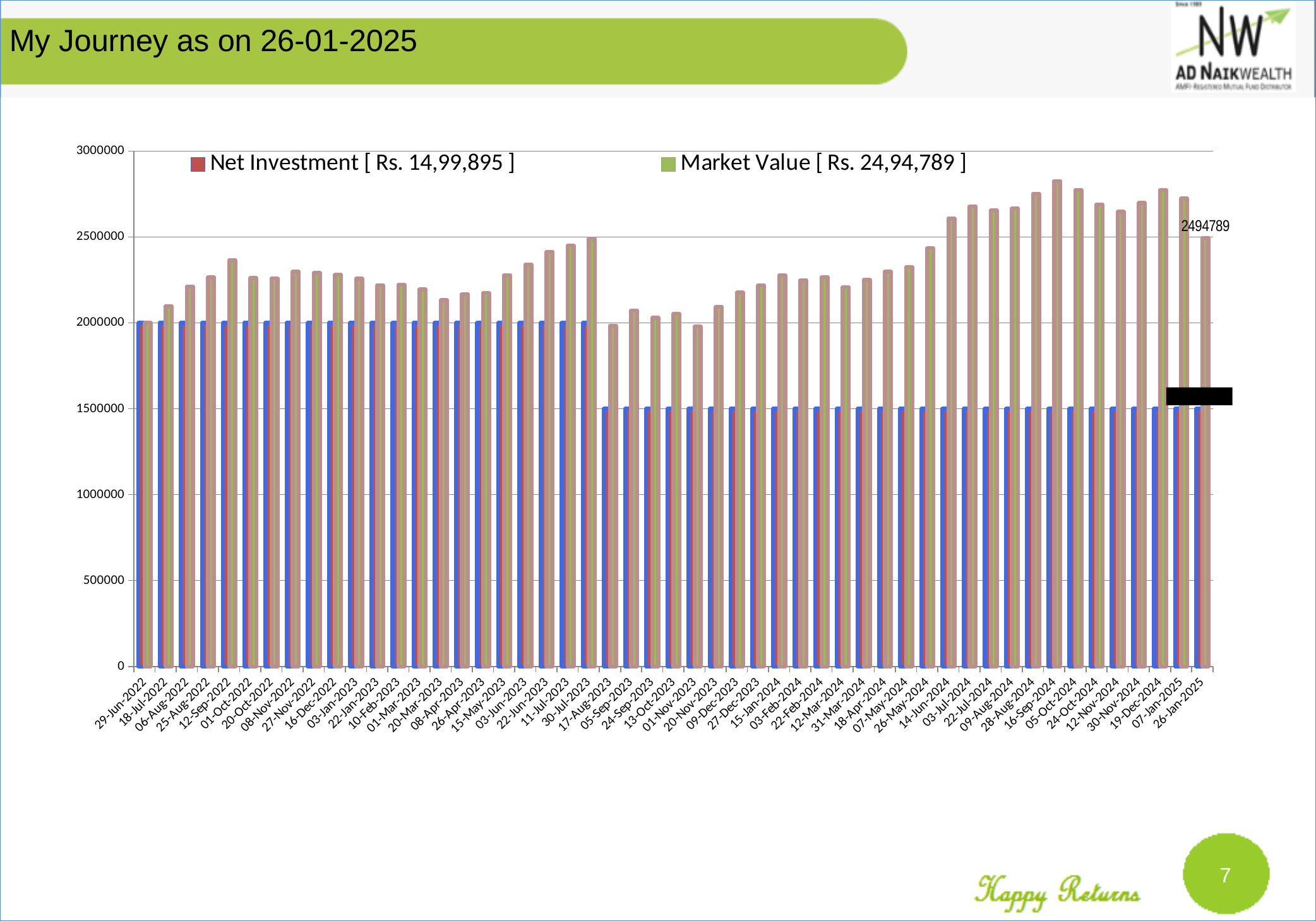
What type of chart is shown on the slide? bar chart Is the Net Investment for 26-Jan-2025 greater or less than 2000000? less How many series does the chart legend list? 2 What is the Market Value data label shown for 26-Jan-2025? 2494789 On which date is the Market Value bar highest? 16-Sep-2024 Which is larger, the Market Value on 16-Sep-2024 or on 26-Jan-2025? 16-Sep-2024 Is the Market Value for 16-Sep-2024 greater or less than 2500000? greater Which is larger, the Net Investment on 29-Jun-2022 or on 26-Jan-2025? 29-Jun-2022 What Market Value amount is shown in the legend entry? Rs. 24,94,789 Is the Market Value for 12-Sep-2022 greater or less than 2000000? greater Does the Market Value generally rise or fall from 17-Aug-2023 to 16-Sep-2024? rise What Net Investment amount is shown in the legend entry? Rs. 14,99,895